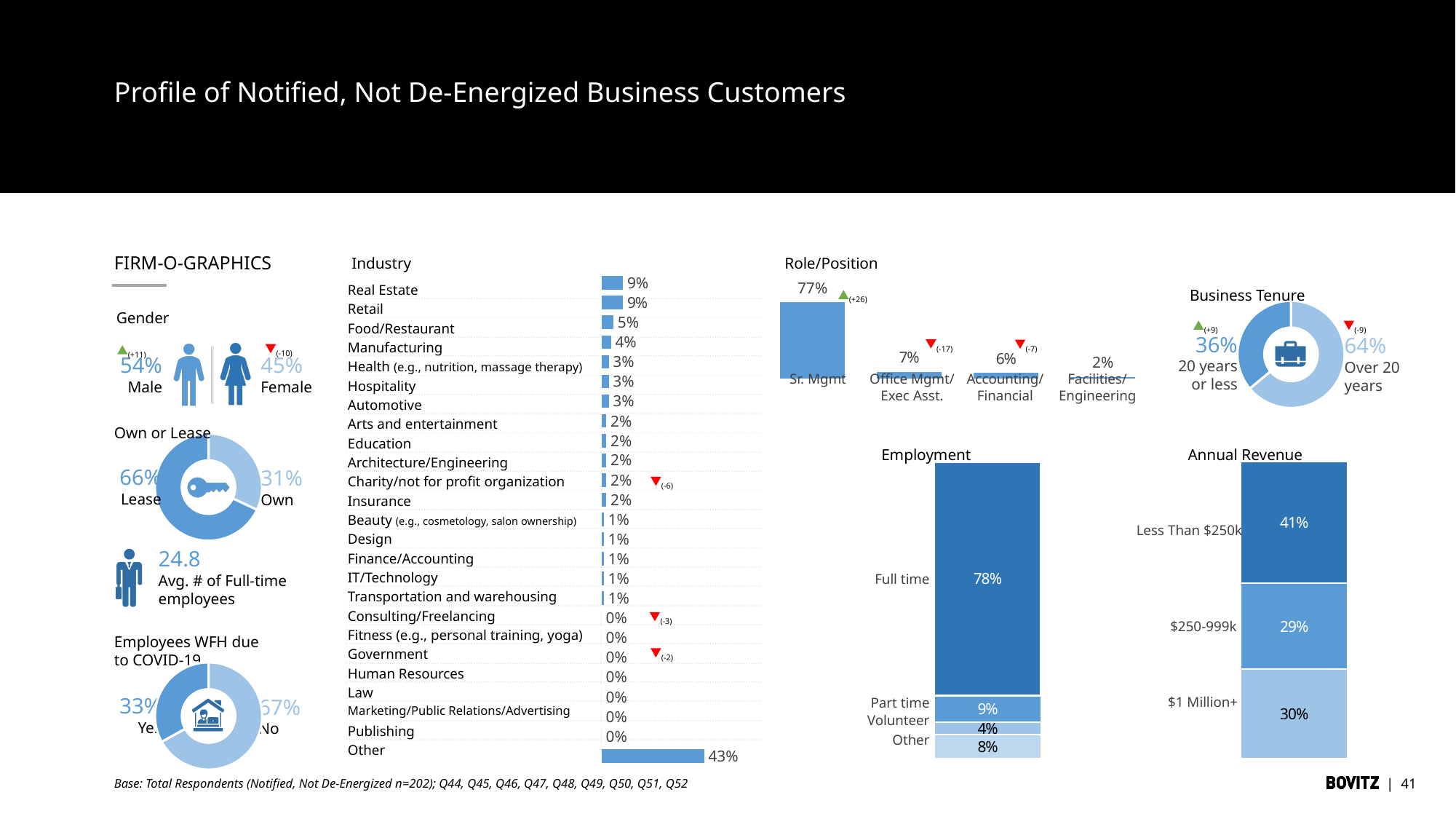
In the Industry chart, what is the value for Food/Restaurant? 5% What kind of chart is the Industry chart? Bar chart In the Employment chart, what is the value for Part time? 9% In the Role/Position chart, what is the value for Sr. Mgmt? 77% In the Role/Position chart, which is larger: Office Mgmt/Exec Asst. or Accounting/Financial? Office Mgmt/Exec Asst. In the Role/Position chart, which category has the lowest value? Facilities/Engineering In the Industry chart, how many industry categories are listed? 25 In the Industry chart, what is the difference between Other and Real Estate? 34% In the Industry chart, which category has the highest value? Other In the Annual Revenue chart, which is larger: $250-999k or $1 Million+? $1 Million+ In the Business Tenure chart, what share of the donut is Over 20 years? 64% In the Annual Revenue chart, what is the total of the stacked bar? 100%